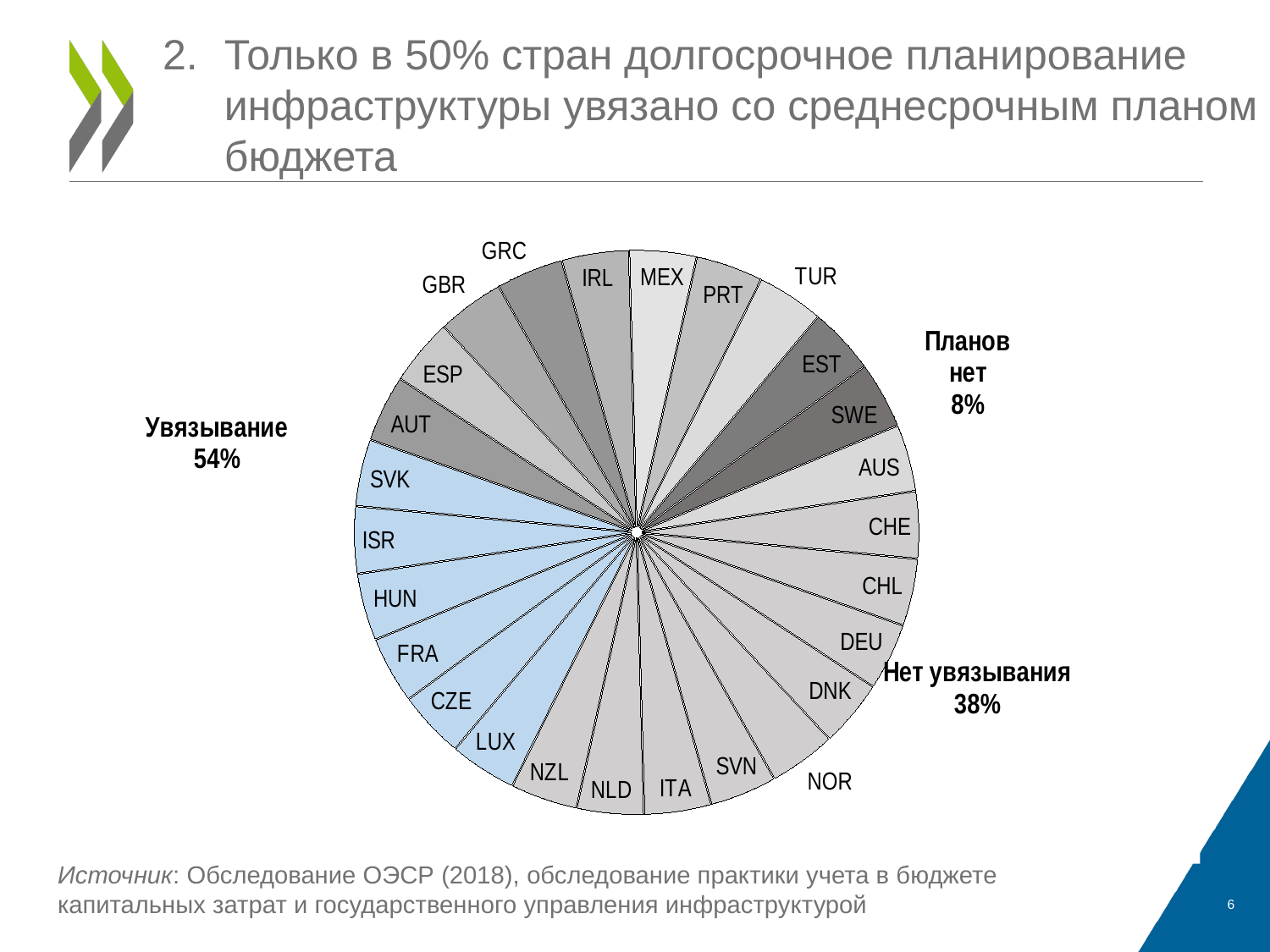
Which group does the SWE slice belong to? Планов нет What kind of chart is shown on the slide? pie chart How many country slices are in the "Планов нет" group? 2 What share of the pie is labelled "Увязывание"? 54% Which of the three groups has the smallest share of the pie? Планов нет What share of the pie is labelled "Планов нет"? 8% Which group has a larger share: "Нет увязывания" or "Планов нет"? Нет увязывания What share of the pie is labelled "Нет увязывания"? 38% Which group does the NOR slice belong to? Нет увязывания Which of the three groups has the largest share of the pie? Увязывание By how many percentage points does the "Увязывание" share exceed the "Нет увязывания" share? 16